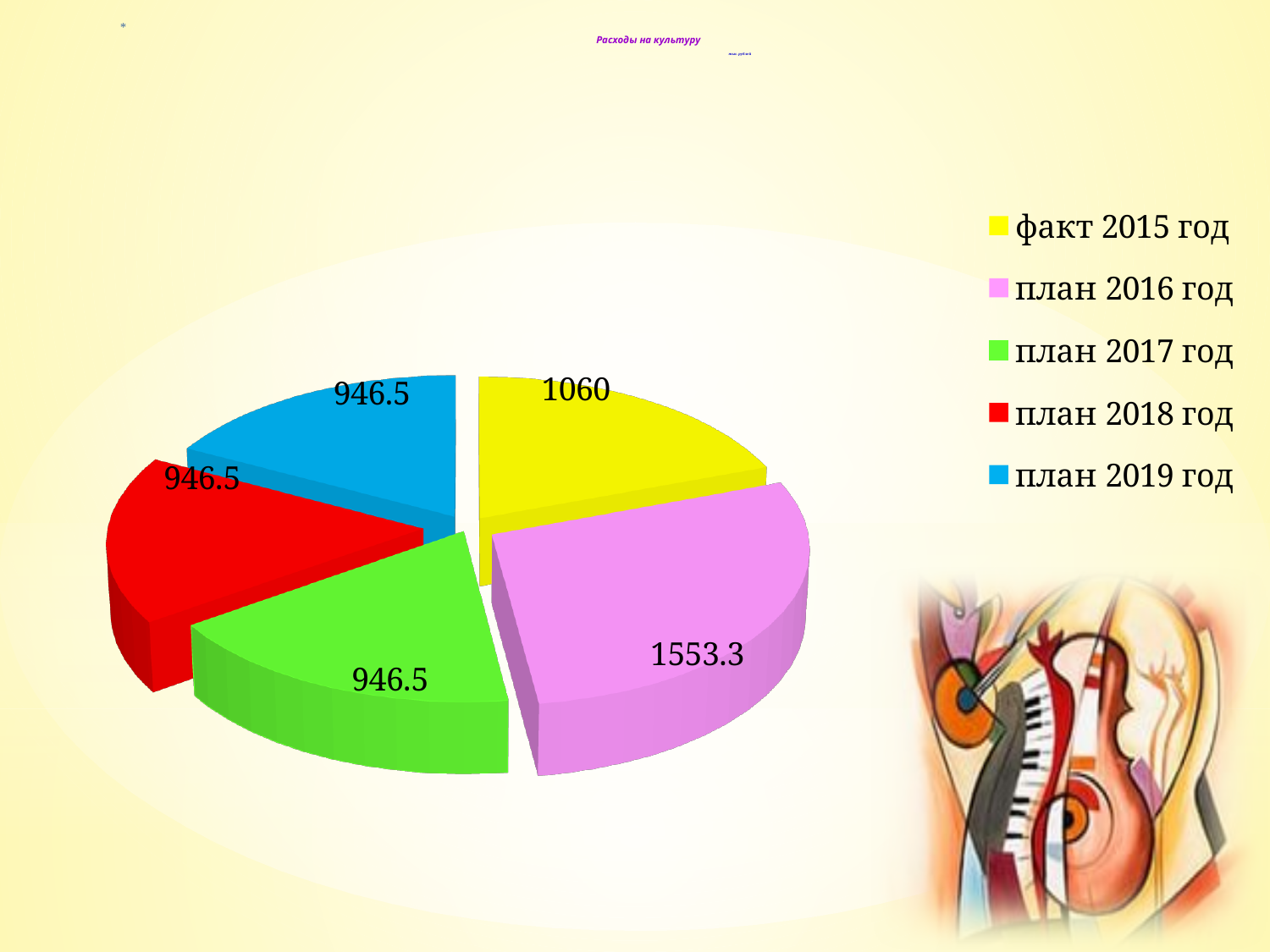
What is the difference between the values for факт 2015 год and план 2018 год? 113.5 How many slices does the pie chart have? 5 What is the value for факт 2015 год? 1060 What is the value for план 2017 год? 946.5 Which is larger, the value for факт 2015 год or the value for план 2017 год? факт 2015 год What type of chart is shown on the slide? pie chart Which category has the largest slice of the pie? план 2016 год How many entries does the legend list? 5 What is the difference between the values for план 2016 год and факт 2015 год? 493.3 What colour is the slice for план 2018 год? red What is the value for план 2016 год? 1553.3 What is the value for план 2019 год? 946.5